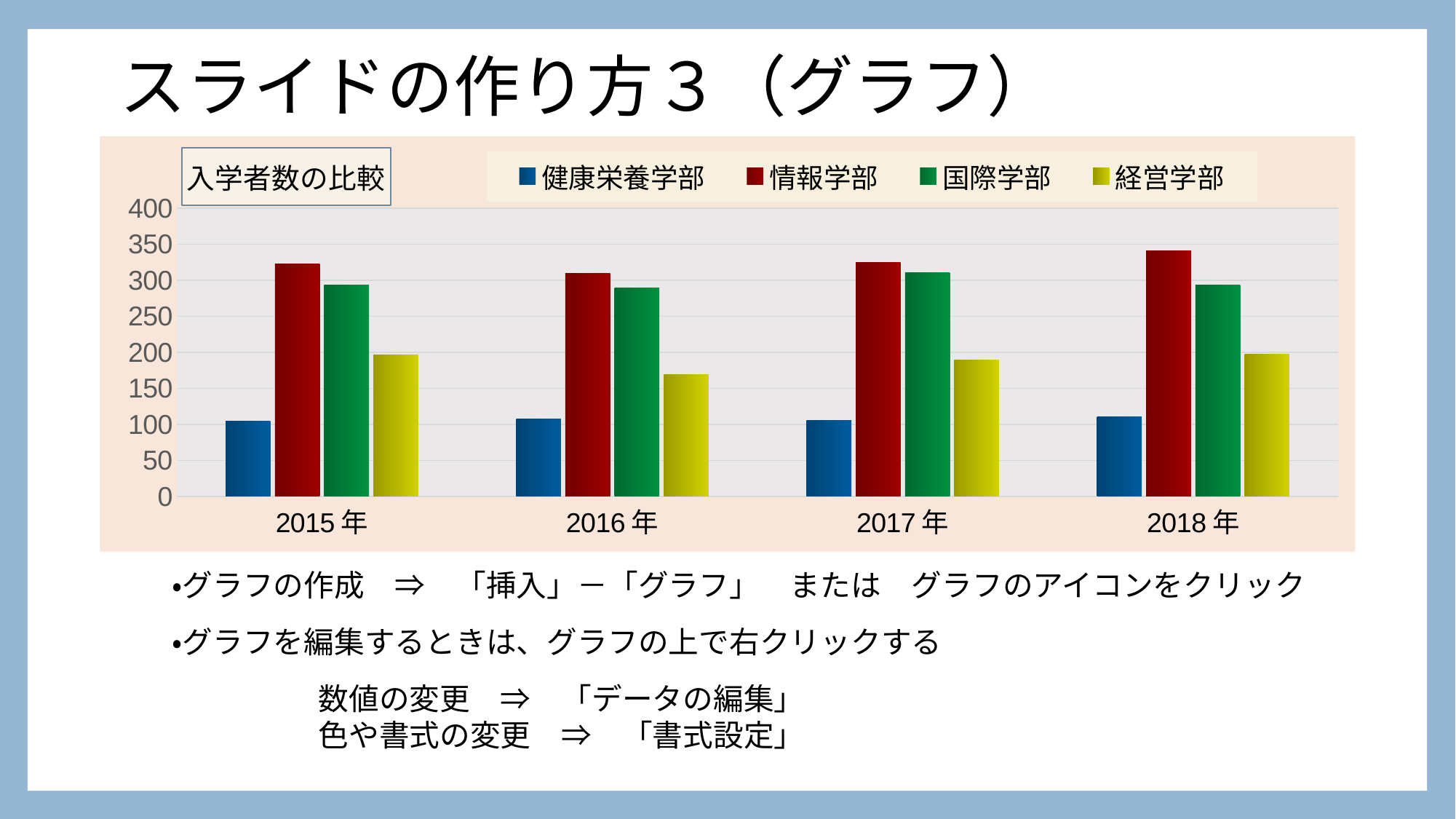
Which series has the lowest value in 2015年? 健康栄養学部 Which is larger in 2017年: the value for 国際学部 or the value for 経営学部? 国際学部 How many series does the legend list? 4 Is the value for 健康栄養学部 in 2017年 greater or less than 150? less Which year has the highest value for 情報学部? 2018年 How many year categories are shown on the x axis? 4 Is the value for 経営学部 in 2016年 greater or less than 200? less Which series is shown in red in the legend? 情報学部 What kind of chart is shown on the slide? bar chart Is the value for 情報学部 in 2018年 greater or less than 300? greater Which series has the highest value in 2018年? 情報学部 What is the title of the chart? 入学者数の比較